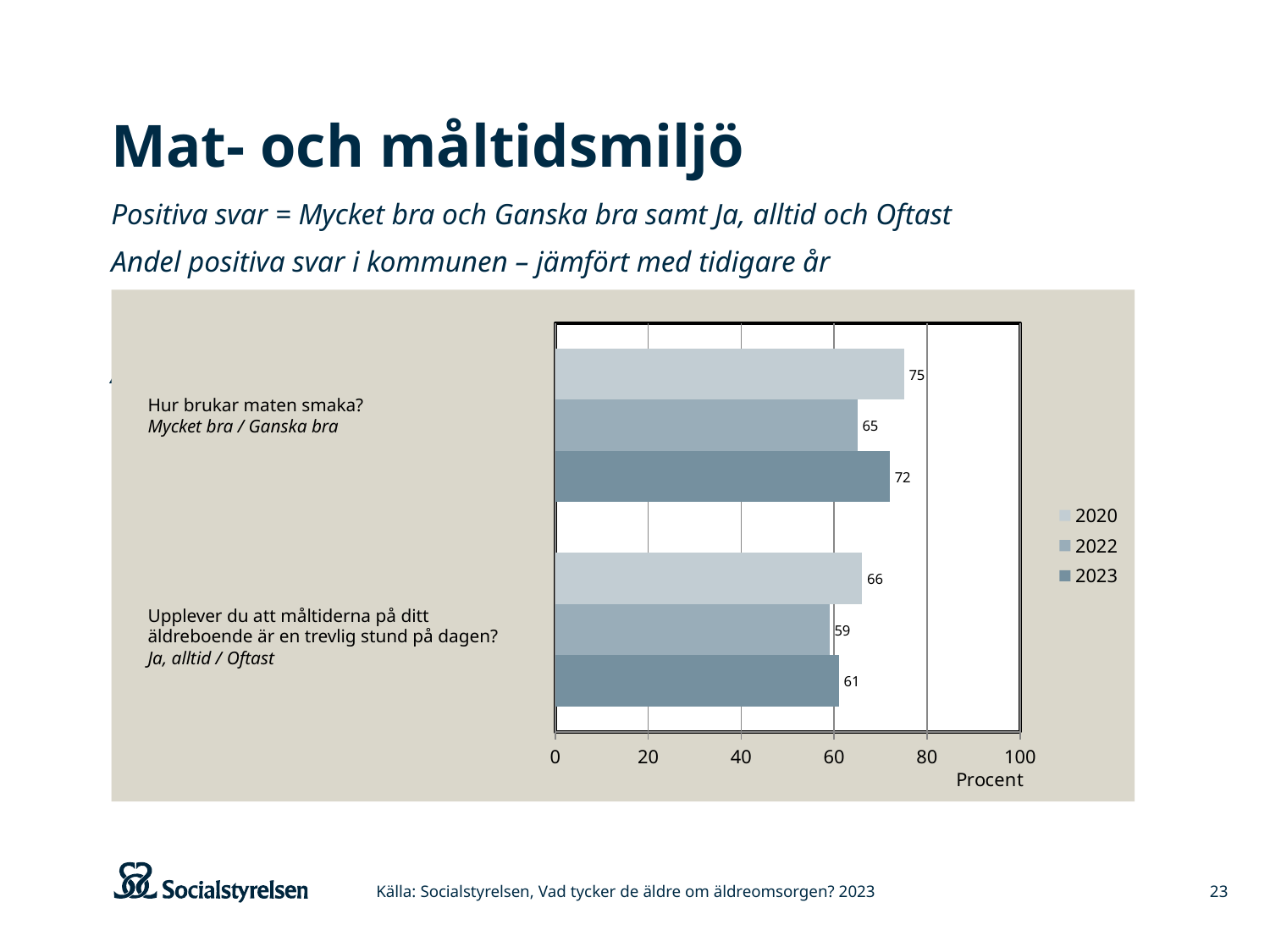
What is the value for 2022 for "Hur brukar maten smaka?"? 65 Which is larger: the 2023 value for "Hur brukar maten smaka?" or the 2023 value for "Upplever du att måltiderna på ditt äldreboende är en trevlig stund på dagen?"? Hur brukar maten smaka? What is the value for 2023 for "Hur brukar maten smaka?"? 72 What kind of chart is shown on the slide? bar chart What is the label of the x axis? Procent Which year has the lowest value for "Upplever du att måltiderna på ditt äldreboende är en trevlig stund på dagen?"? 2022 Which year has the highest value for "Hur brukar maten smaka?"? 2020 What is the difference between the 2023 and 2022 values for "Upplever du att måltiderna på ditt äldreboende är en trevlig stund på dagen?"? 2 Is the 2022 value for "Upplever du att måltiderna på ditt äldreboende är en trevlig stund på dagen?" greater or less than 60? less What is the value for 2020 for "Upplever du att måltiderna på ditt äldreboende är en trevlig stund på dagen?"? 66 How many series does the legend list? 3 What is the difference between the 2020 and 2022 values for "Hur brukar maten smaka?"? 10